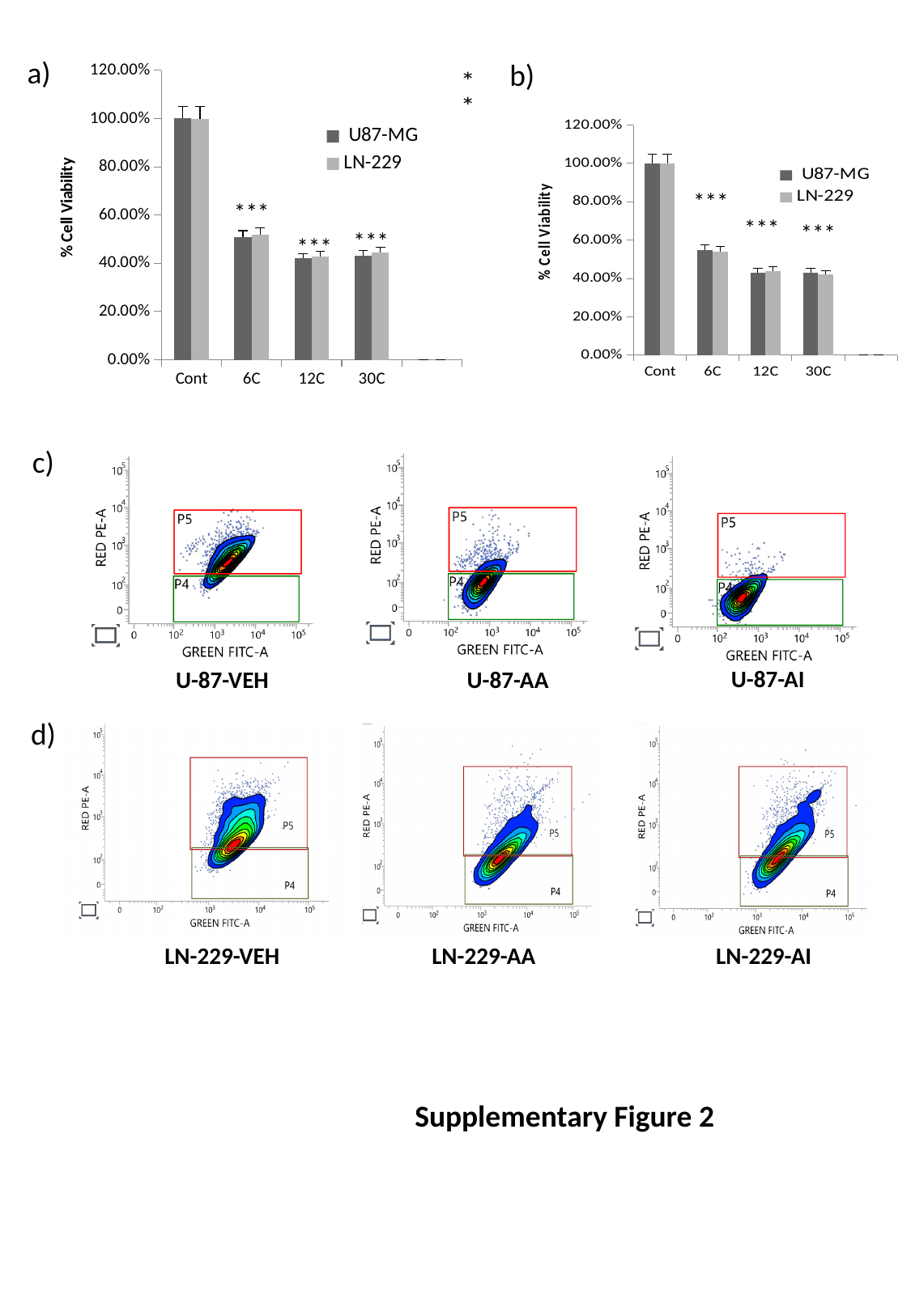
In chart b), which category has the lowest % Cell Viability for LN-229? 30C In chart b), which is larger for U87-MG: the value for 6C or the value for 12C? 6C In chart b), is the U87-MG value for 12C greater or less than 60.00%? less In chart a), which category has the highest % Cell Viability for U87-MG? Cont In chart a), is the LN-229 value for 12C greater or less than 60.00%? less In chart a), is the U87-MG value for 6C greater or less than 40.00%? greater In chart b), what is the label of the y axis? % Cell Viability In chart b), how many series does the legend list? 2 In chart a), how many series does the legend list? 2 In chart a), which is larger for U87-MG: the value for Cont or the value for 6C? Cont In chart a), how many categories are shown on the x axis? 4 In chart a), what type of chart is used to show % Cell Viability? bar chart